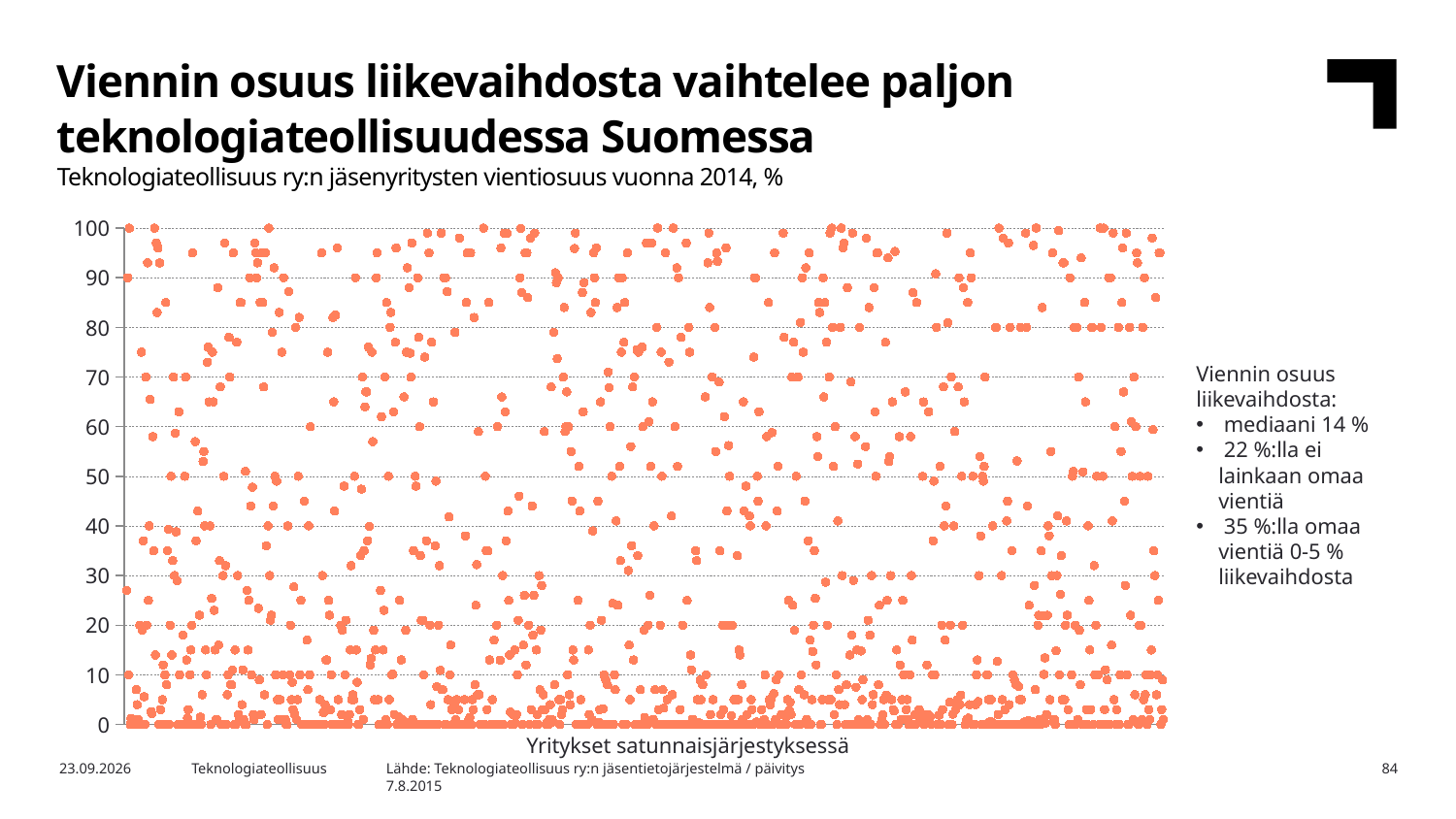
What is the maximum value shown on the y axis of the chart? 100 According to the text next to the chart, what is the median export share of turnover? 14 % What is the highest value plotted on the chart? 100 According to the text next to the chart, what share of companies have no exports at all? 22 % What kind of chart is shown on the slide? scatter chart What is the lowest value plotted on the chart? 0 Do the plotted values show a clear rising or falling trend along the x axis? no What is the label of the x axis of the chart? Yritykset satunnaisjärjestyksessä According to the text next to the chart, what share of companies have exports of 0-5 % of turnover? 35 %